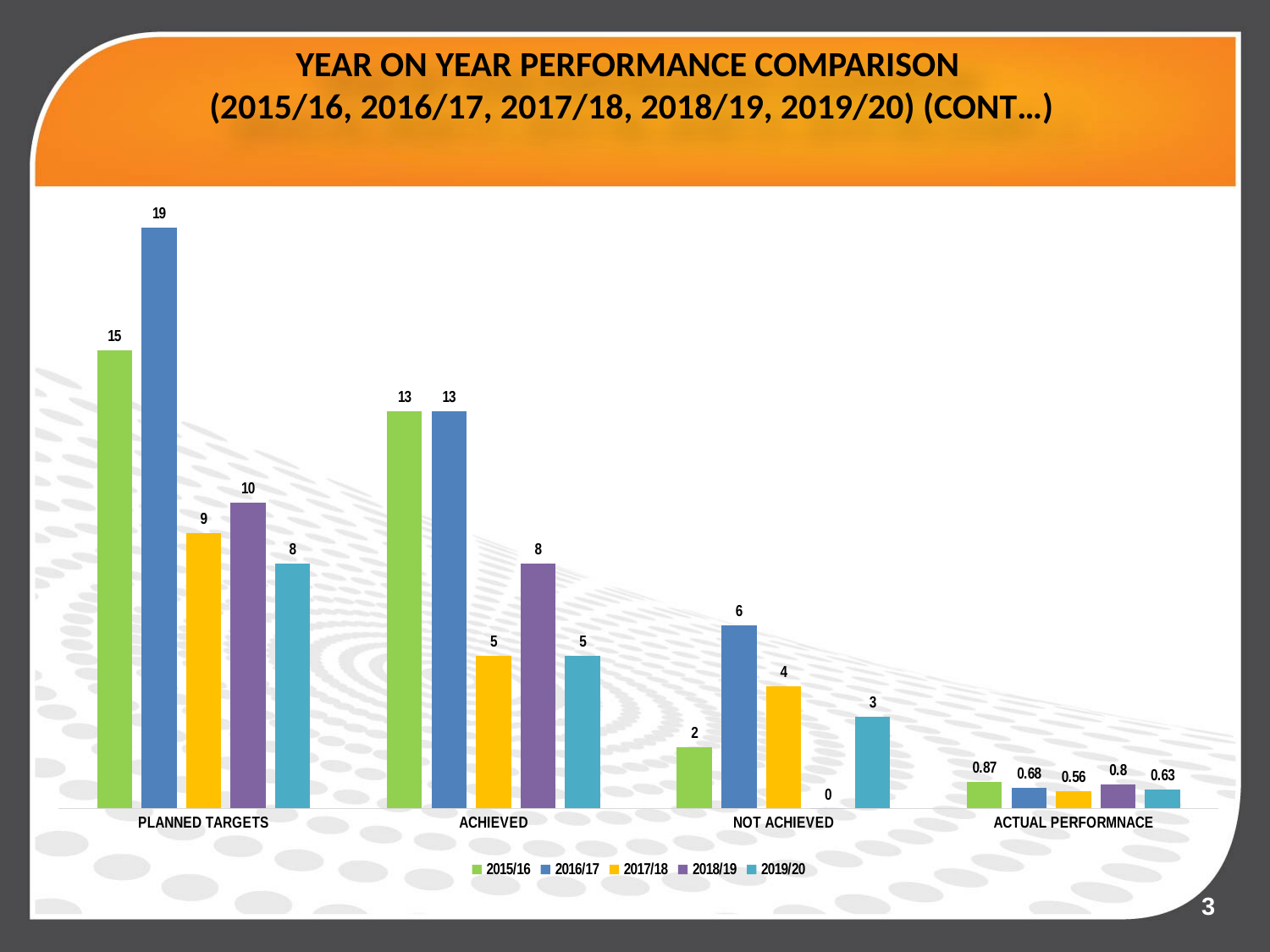
What is the value for 2017/18 in the ACHIEVED category? 5 In the NOT ACHIEVED category, which is larger: the value for 2016/17 or the value for 2019/20? 2016/17 What is the value for 2016/17 in the PLANNED TARGETS category? 19 What is the difference between the 2016/17 and 2015/16 values in the PLANNED TARGETS category? 4 What is the value for 2018/19 in the NOT ACHIEVED category? 0 What kind of chart is shown on the slide? bar chart How many series does the legend list? 5 Which year has the lowest value in the ACTUAL PERFORMNACE category? 2017/18 What is the value for 2015/16 in the ACTUAL PERFORMNACE category? 0.87 How many categories are shown on the x axis? 4 Which colour represents the 2017/18 series in the legend? yellow Which year has the highest value in the PLANNED TARGETS category? 2016/17